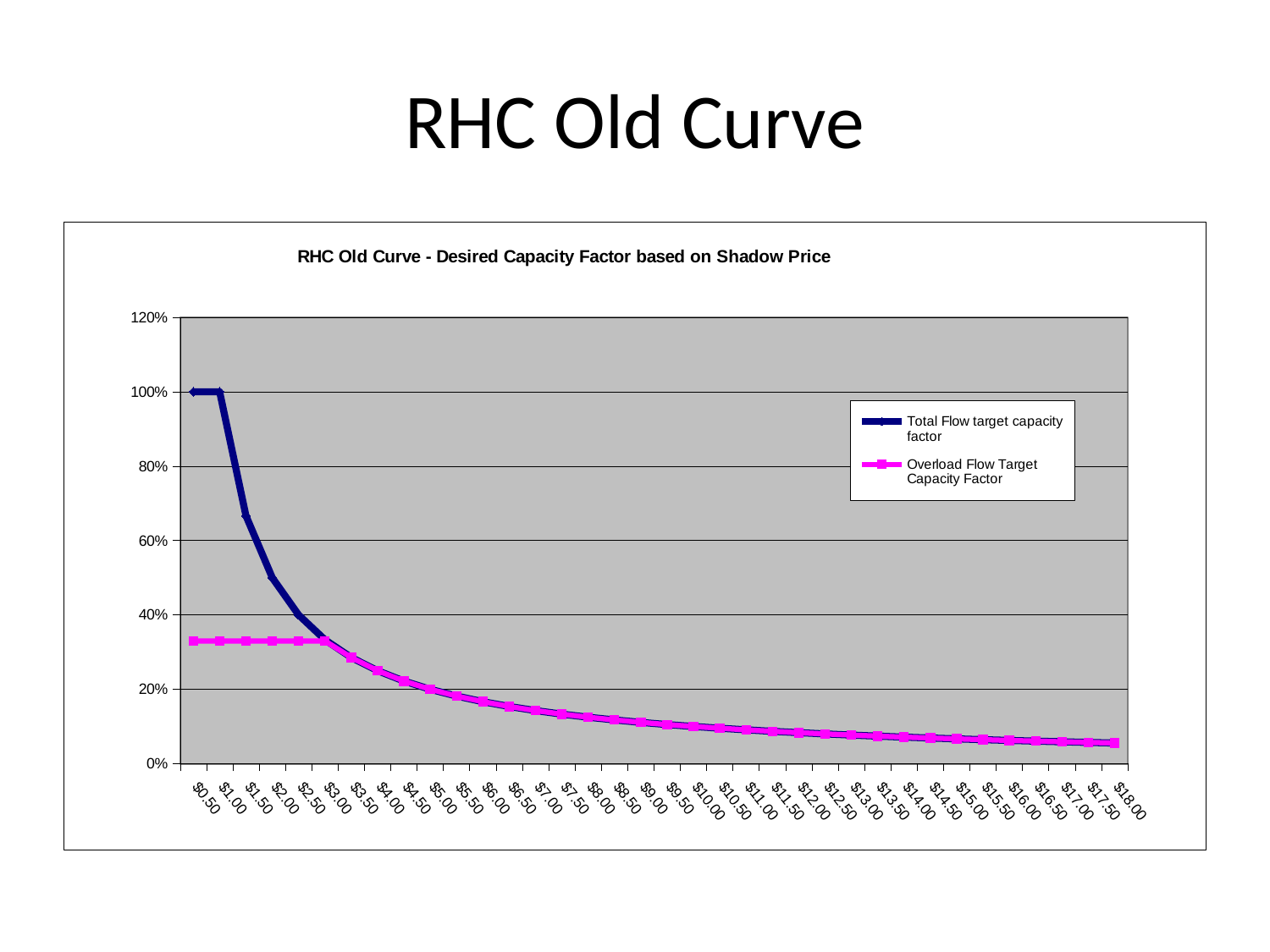
Does the Total Flow target capacity factor rise or fall as the shadow price increases along the x axis? fall At $1.00, which series has the larger value: Total Flow target capacity factor or Overload Flow Target Capacity Factor? Total Flow target capacity factor Is the Total Flow target capacity factor at $18.00 greater or less than 20%? less What is the value of the Total Flow target capacity factor at $0.50? 100% What is the value of the Total Flow target capacity factor at $1.00? 100% Is the Total Flow target capacity factor at $1.50 greater or less than 60%? greater Is the Overload Flow Target Capacity Factor at $0.50 greater or less than 40%? less At which shadow price is the Overload Flow Target Capacity Factor lowest? $18.00 What colour is the line for the Overload Flow Target Capacity Factor? magenta How many series does the legend list? 2 What is the title of the chart? RHC Old Curve - Desired Capacity Factor based on Shadow Price What kind of chart is shown on the slide? line chart